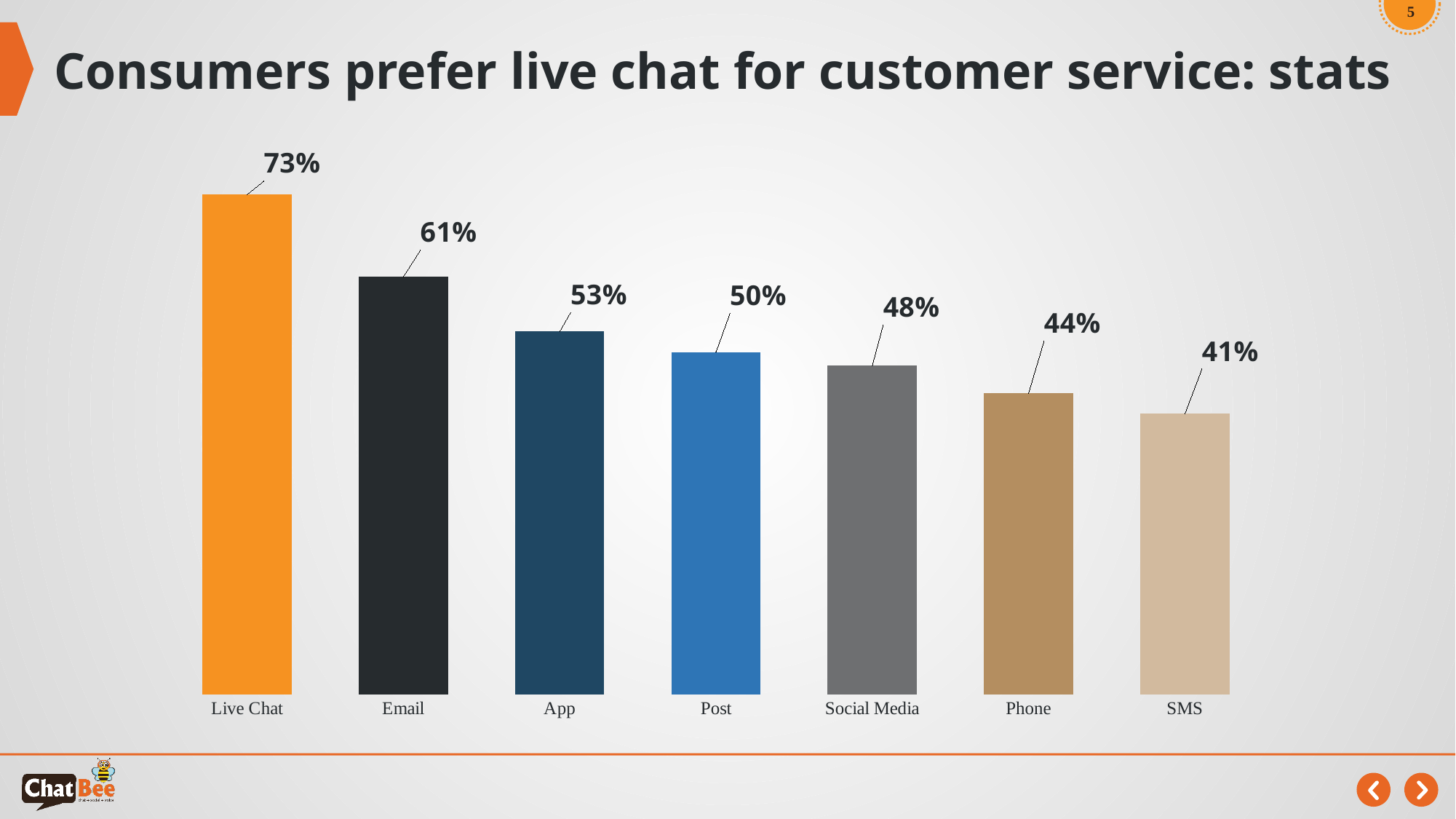
What is the difference between the values for App and Phone? 9% Which is larger, the value for Post or the value for Phone? Post What is the value for Social Media? 48% What colour is the Live Chat bar? Orange Do the values rise or fall from left to right across the categories? Fall Which category has the lowest value? SMS Which category has the highest value? Live Chat How many categories are shown in the chart? 7 What is the value for SMS? 41% What kind of chart is shown on the slide? Bar chart What is the difference between the values for Live Chat and Email? 12% What is the value for Live Chat? 73%